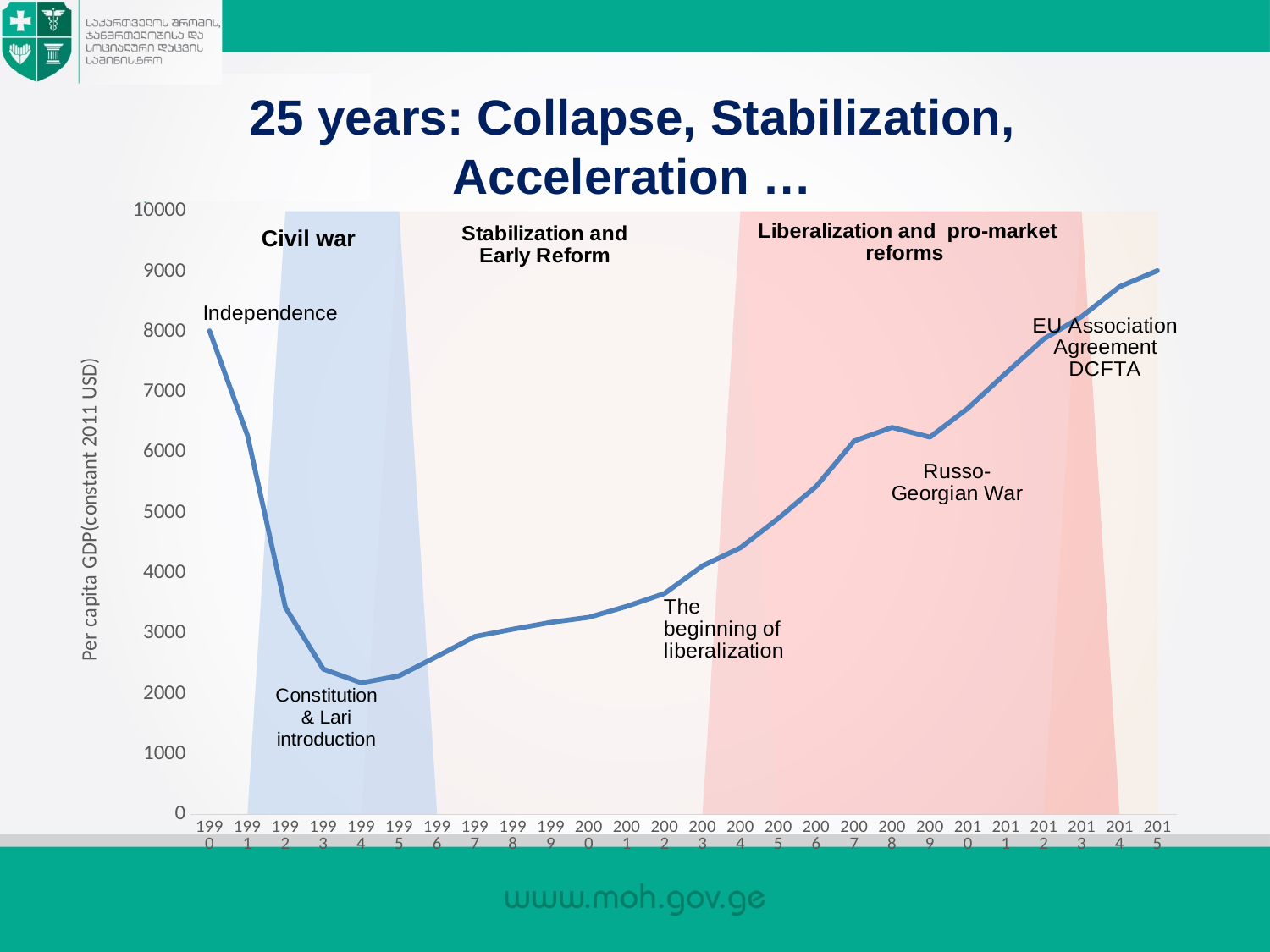
What is the title of the slide? 25 years: Collapse, Stabilization, Acceleration … Is the value for 2002 greater or less than 4000? less Which year has the higher per capita GDP, 1990 or 2015? 2015 What kind of chart is shown on the slide? Line chart How many years (data points) are plotted along the x axis? 26 Is the value for 1994 greater or less than 3000? less Does per capita GDP rise or fall between 1990 and 1994? Fall Is the value for 2015 greater or less than 8000? greater What is the label on the y axis? Per capita GDP(constant 2011 USD) In which year is per capita GDP at its lowest? 1994 In which year is per capita GDP at its highest? 2015